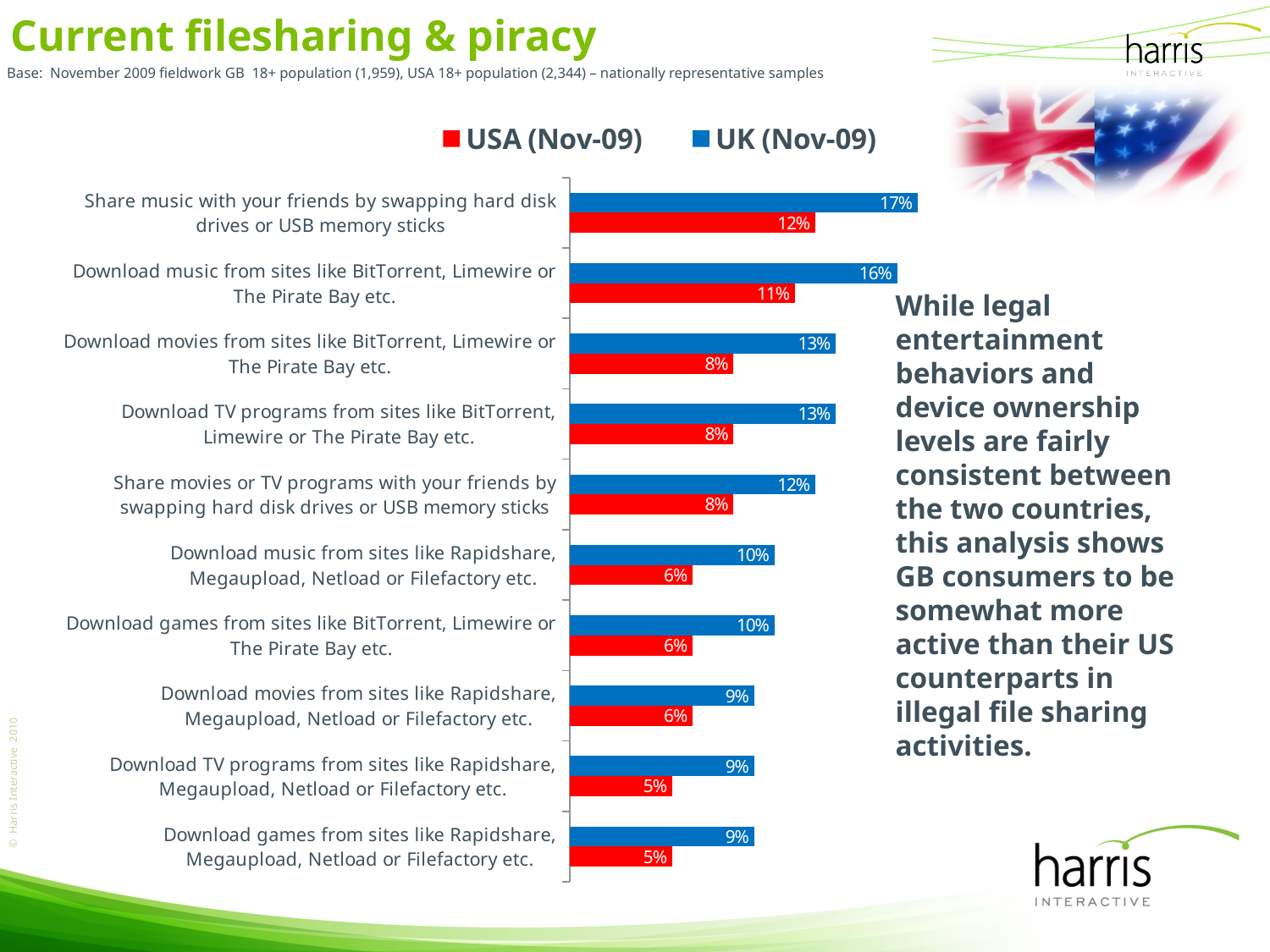
Which colour represents the USA (Nov-09) series? Red What is the lowest USA (Nov-09) value shown on the chart? 5% What is the USA (Nov-09) value for 'Download music from sites like BitTorrent, Limewire or The Pirate Bay etc.'? 11% How many categories are shown on the chart? 10 What is the difference between the UK (Nov-09) and USA (Nov-09) values for 'Download movies from sites like BitTorrent, Limewire or The Pirate Bay etc.'? 5% Which category has the highest UK (Nov-09) value? Share music with your friends by swapping hard disk drives or USB memory sticks What is the UK (Nov-09) value for 'Share music with your friends by swapping hard disk drives or USB memory sticks'? 17% For 'Share movies or TV programs with your friends by swapping hard disk drives or USB memory sticks', which series has the larger value, USA (Nov-09) or UK (Nov-09)? UK (Nov-09) What kind of chart is shown on the slide? Bar chart How many series does the legend list? 2 What is the USA (Nov-09) value for 'Download TV programs from sites like Rapidshare, Megaupload, Netload or Filefactory etc.'? 5% What is the UK (Nov-09) value for 'Download games from sites like BitTorrent, Limewire or The Pirate Bay etc.'? 10%